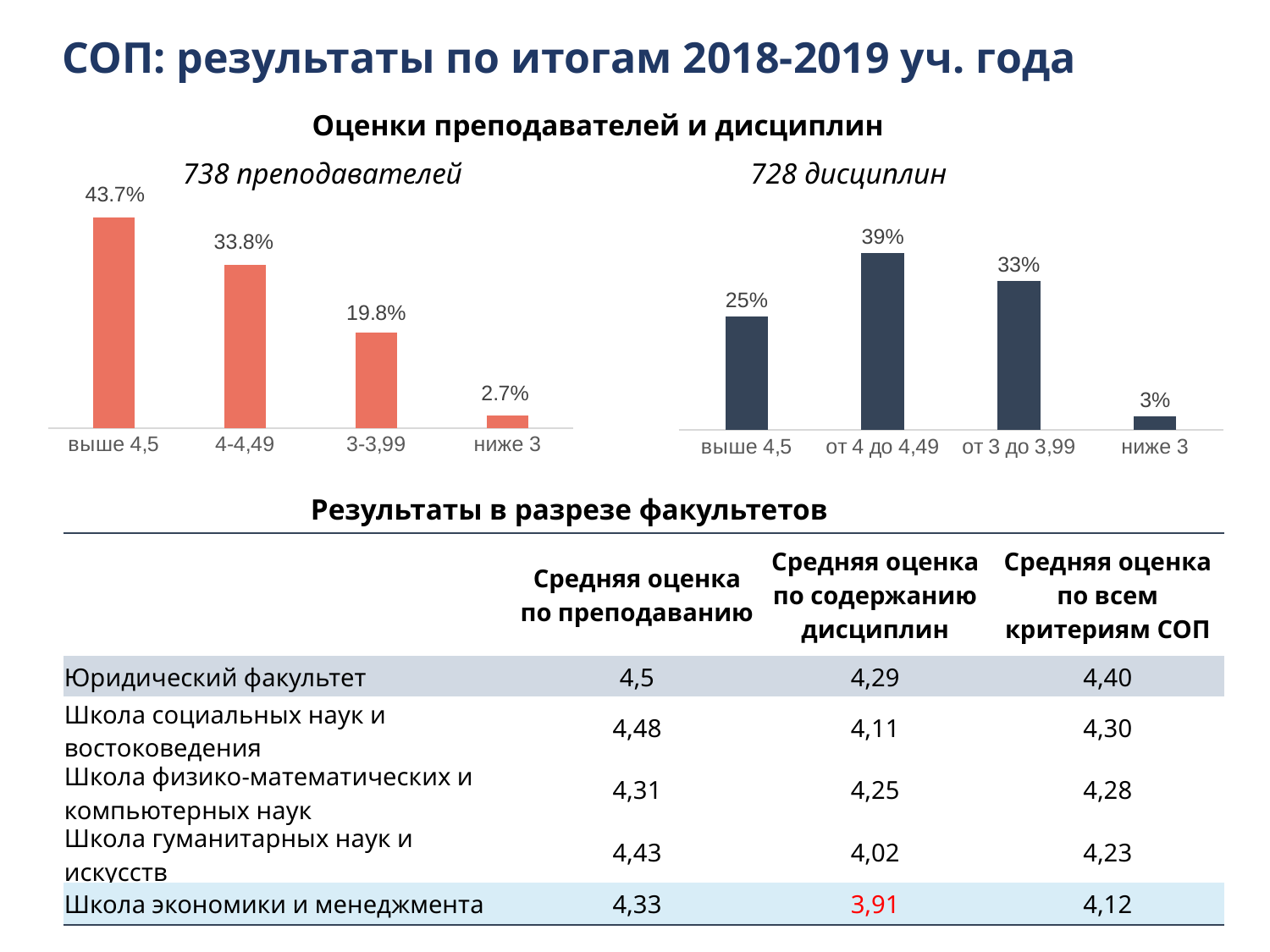
In the '728 дисциплин' chart, what is the value for 'ниже 3'? 3% What type of chart is the '728 дисциплин' chart? Bar chart In the '738 преподавателей' chart, what is the value for '3-3,99'? 19.8% In the '738 преподавателей' chart, which category has the highest value? выше 4,5 In the '728 дисциплин' chart, which is larger: the value for 'от 3 до 3,99' or the value for 'выше 4,5'? от 3 до 3,99 In the '728 дисциплин' chart, what is the difference between the values for 'от 4 до 4,49' and 'выше 4,5'? 14% In the '728 дисциплин' chart, which category has the lowest value? ниже 3 In the '738 преподавателей' chart, what is the value for 'выше 4,5'? 43.7% In the '728 дисциплин' chart, which category has the highest value? от 4 до 4,49 In the '728 дисциплин' chart, what is the value for 'от 4 до 4,49'? 39% In the '738 преподавателей' chart, what is the difference between the values for 'выше 4,5' and '4-4,49'? 9.9% How many categories are shown in the '738 преподавателей' chart? 4